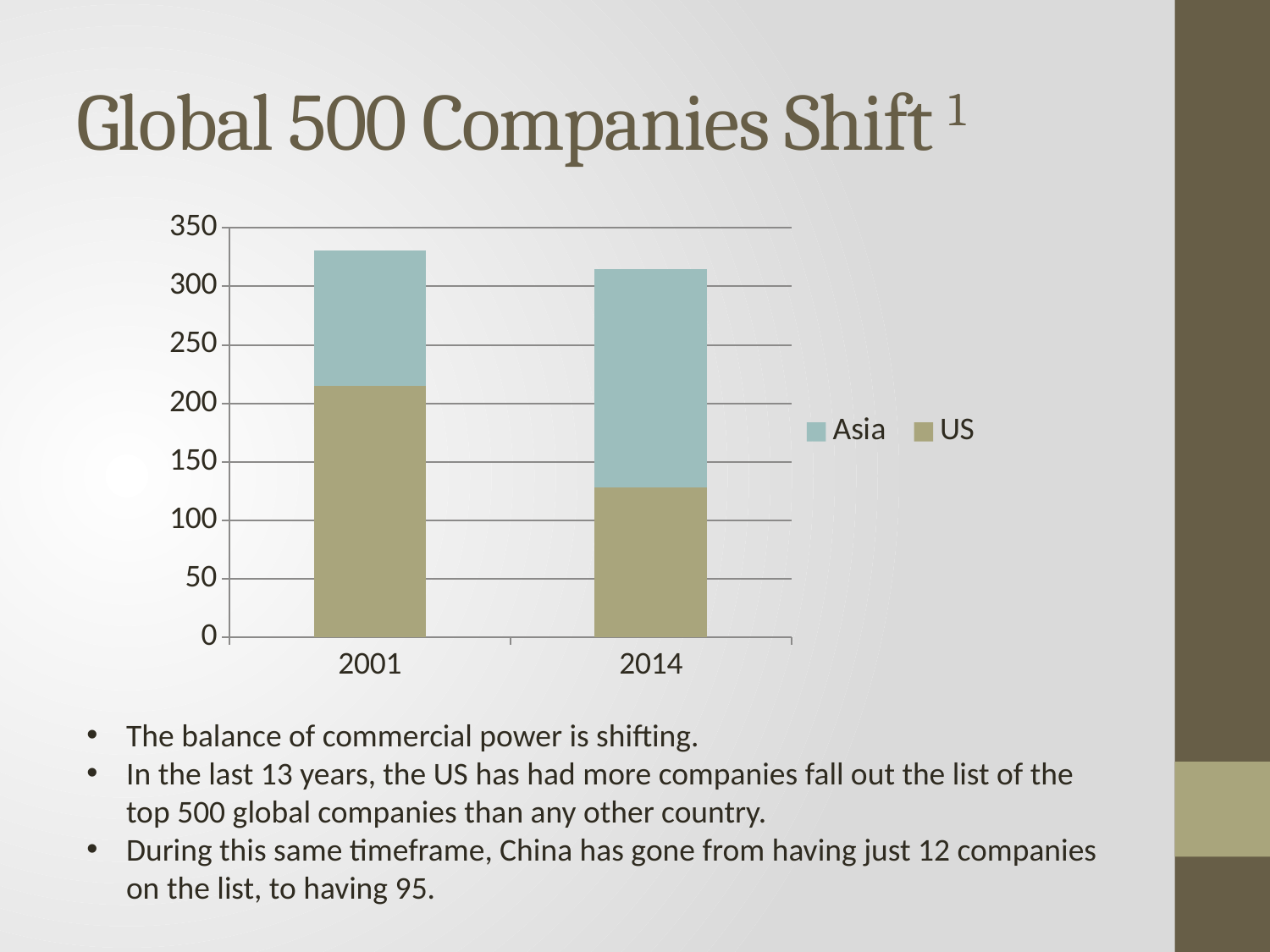
Which year has the larger US value, 2001 or 2014? 2001 Which year has the larger Asia segment, 2001 or 2014? 2014 Is the Asia segment for 2001 greater or less than 100? greater Is the total height of the 2001 stacked bar greater or less than 300? greater Is the Asia segment for 2014 greater or less than 150? greater Which series does the legend list first? Asia What kind of chart is shown on the slide? stacked bar chart How many series does the chart legend list? 2 Does the US value rise or fall from 2001 to 2014? fall How many years are shown on the x axis of the chart? 2